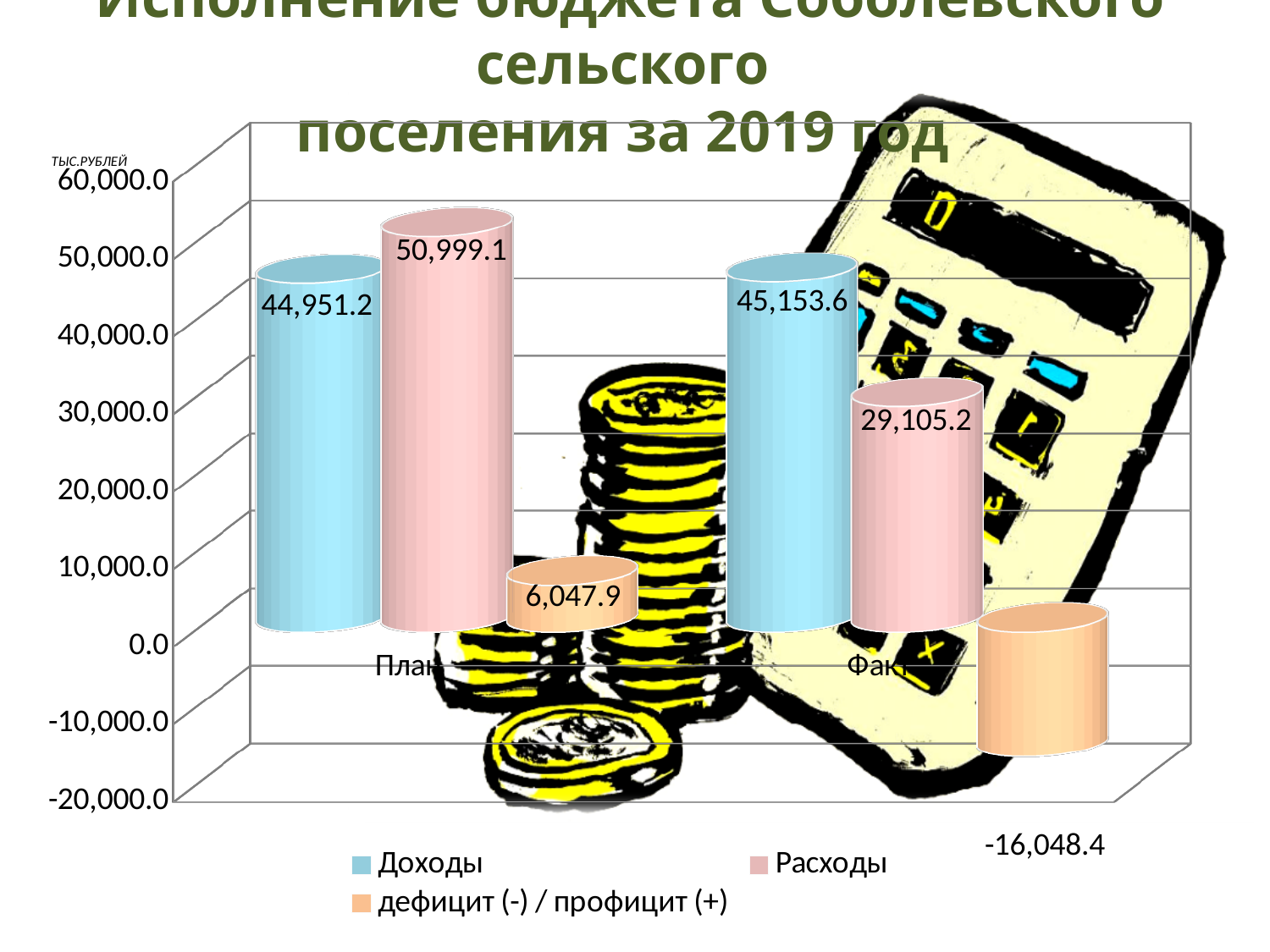
How many categories are shown on the x axis? 2 What kind of chart is shown on the slide? Bar chart What is the value of Расходы for Факт? 29,105.2 What is the value of Доходы for Факт? 45,153.6 What is the value of Доходы for План? 44,951.2 What is the value of дефицит (-) / профицит (+) for План? 6,047.9 For План, which is larger: Доходы or Расходы? Расходы How many series does the legend list? 3 For Факт, which is larger: Доходы or Расходы? Доходы What is the value of Расходы for План? 50,999.1 What is the value of дефицит (-) / профицит (+) for Факт? -16,048.4 What is the difference between Расходы for План and Расходы for Факт? 21,893.9